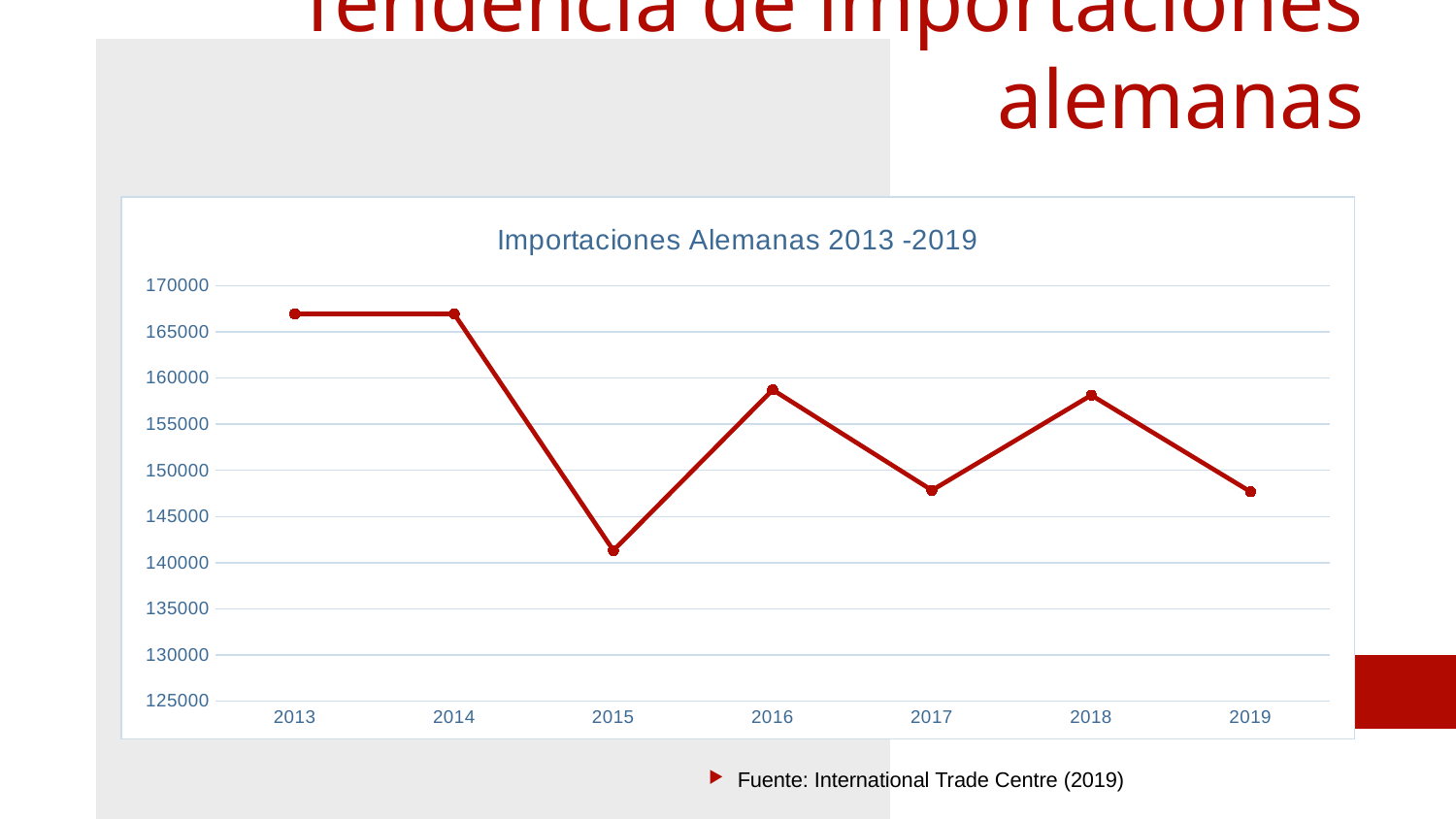
What kind of chart is shown on the slide? line chart Is the value for 2015 greater or less than 145000? less Is the value for 2019 greater or less than 150000? less Does the value rise or fall from 2015 to 2016? rise Which year has the lowest value in the chart? 2015 Does the value rise or fall from 2014 to 2015? fall Is the value for 2016 greater or less than 155000? greater What is the title of the chart? Importaciones Alemanas 2013 -2019 Which is larger, the value for 2015 or the value for 2017? 2017 How many years are plotted on the x axis of the chart? 7